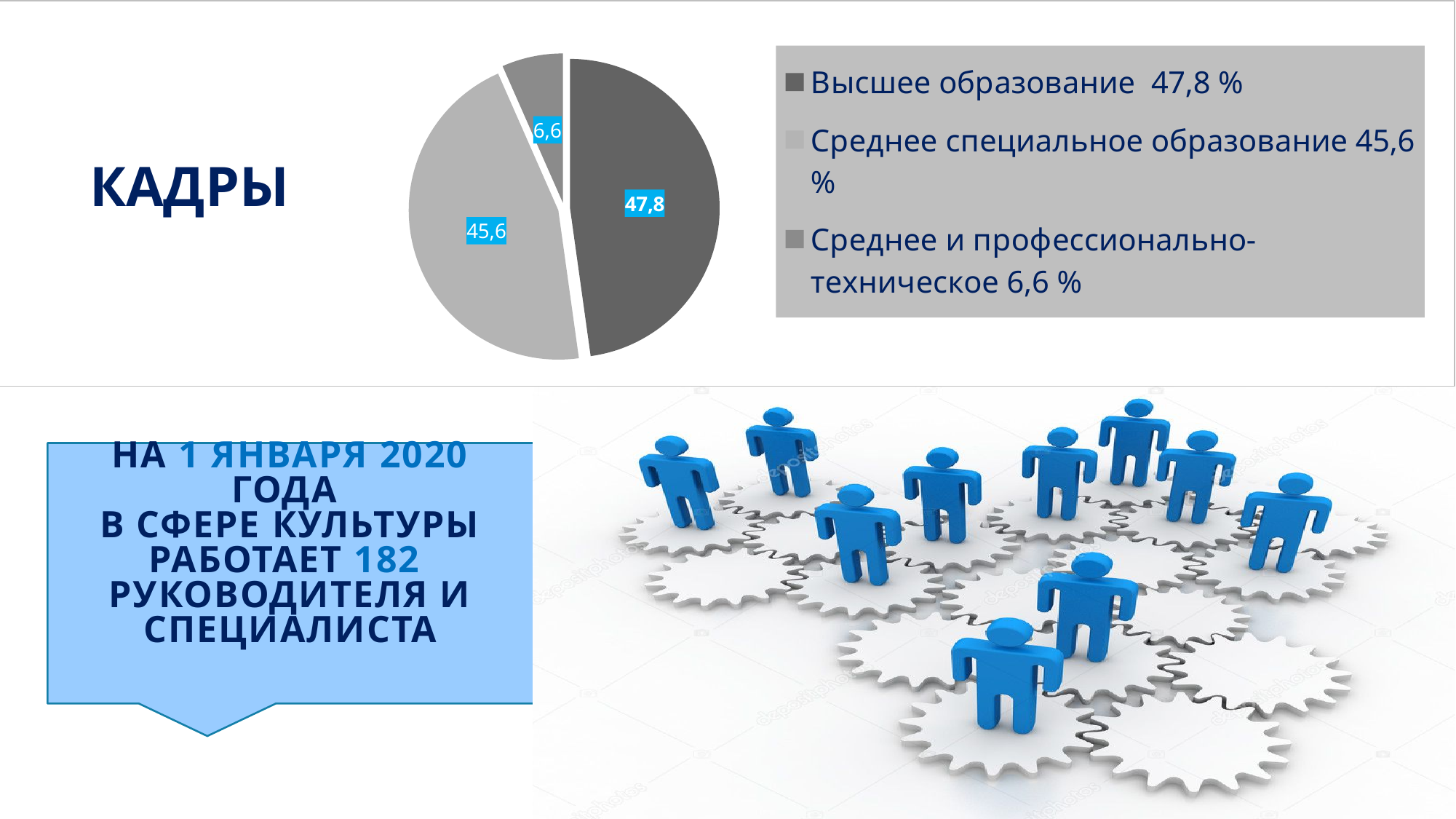
Which is larger: the value for Среднее специальное образование or the value for Среднее и профессионально-техническое? Среднее специальное образование What share of the pie does Среднее и профессионально-техническое represent? 6,6 % What is the difference between the values for Высшее образование and Среднее специальное образование? 2,2 What is the value for Высшее образование in the pie chart? 47,8 How many slices does the pie chart have? 3 What is the value for Среднее специальное образование in the pie chart? 45,6 Which category has the largest slice in the pie chart? Высшее образование What is the title of the slide containing the pie chart? КАДРЫ What kind of chart is shown on the slide? pie chart Which category has the smallest slice in the pie chart? Среднее и профессионально-техническое What is the difference between the values for Высшее образование and Среднее и профессионально-техническое? 41,2 What is the value for Среднее и профессионально-техническое in the pie chart? 6,6